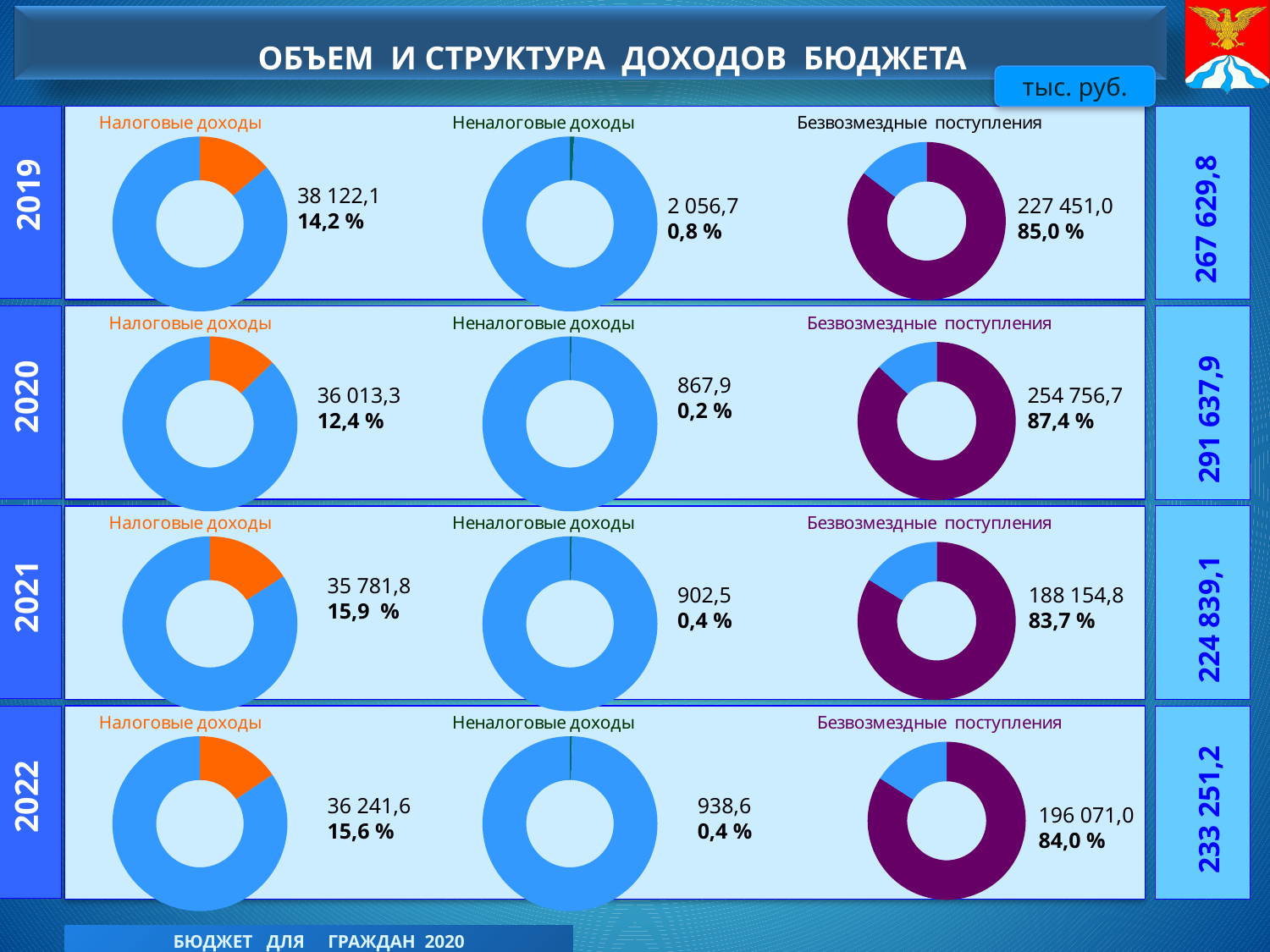
In the 2020 row, what value is shown for the Неналоговые доходы donut chart? 867,9 In the 2021 row, what value is shown for the Безвозмездные поступления donut chart? 188 154,8 In the 2019 row, what share does the Безвозмездные поступления donut chart show? 85,0 % Across the 2022 row, which income category has the highest value? Безвозмездные поступления In the 2022 row, what share does the Неналоговые доходы donut chart show? 0,4 % What is the difference between the Безвозмездные поступления values for 2020 and 2021? 66 601,9 In the 2019 row, what value is shown for the Налоговые доходы donut chart? 38 122,1 Across the 2019 row, which income category has the lowest value? Неналоговые доходы How many donut charts are shown on the slide in total? 12 Which is larger: the Налоговые доходы value for 2019 or for 2020? 2019 In the 2020 row, what share does the Налоговые доходы donut chart show? 12,4 % What kind of chart is used for each of the income categories on the slide? Donut (pie) chart